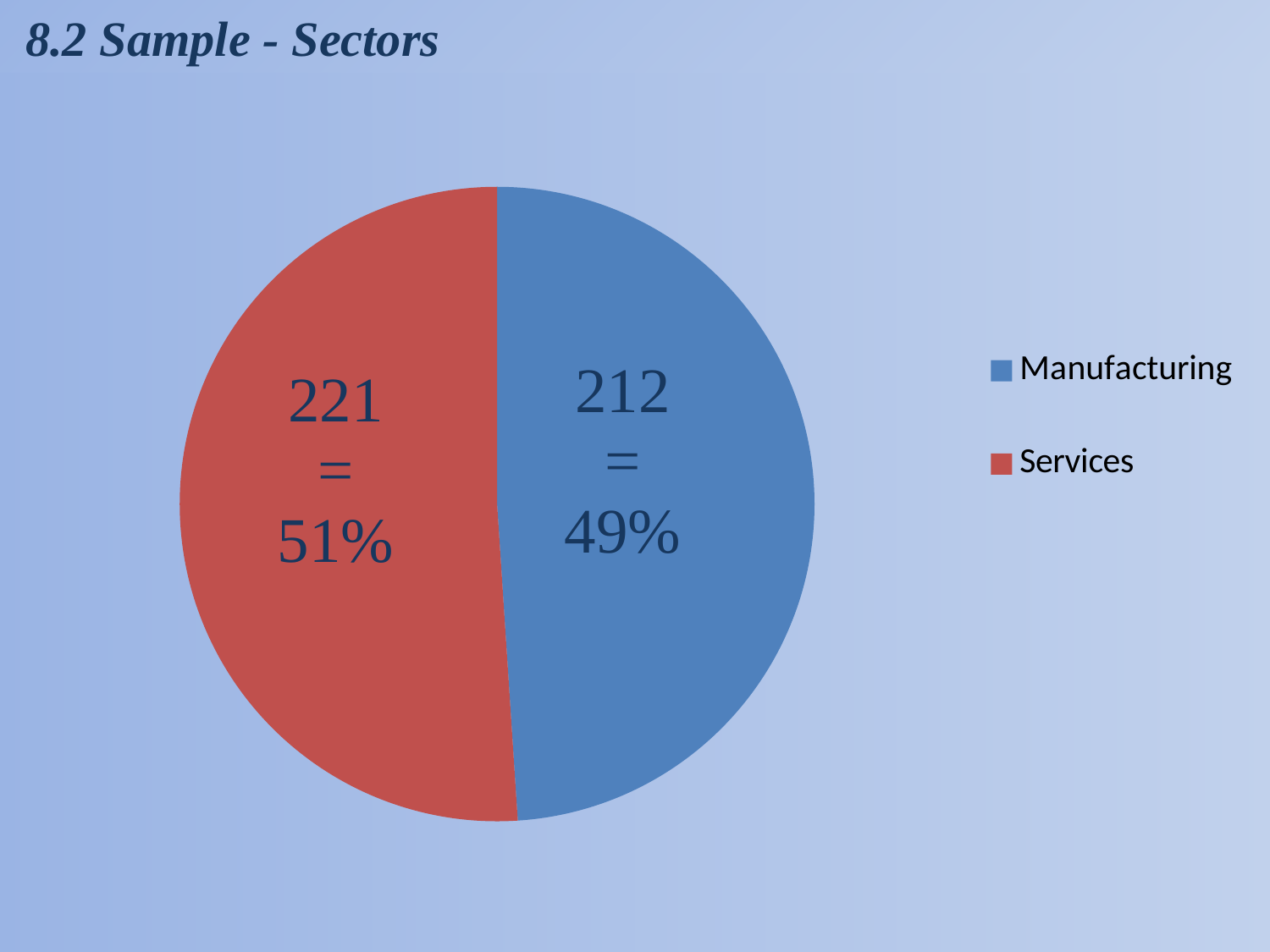
Which sector has the larger count, Manufacturing or Services? Services What share of the pie does Manufacturing represent? 49% What share of the pie does Services represent? 51% What is the count for Manufacturing? 212 How many slices does the pie chart have? 2 What is the total of the two slices? 433 Which sector has the smallest slice? Manufacturing Which colour represents Services in the pie chart? red What kind of chart is shown on the slide? pie chart What is the count for Services? 221 What is the difference between the Services count and the Manufacturing count? 9 How many entries does the legend list? 2